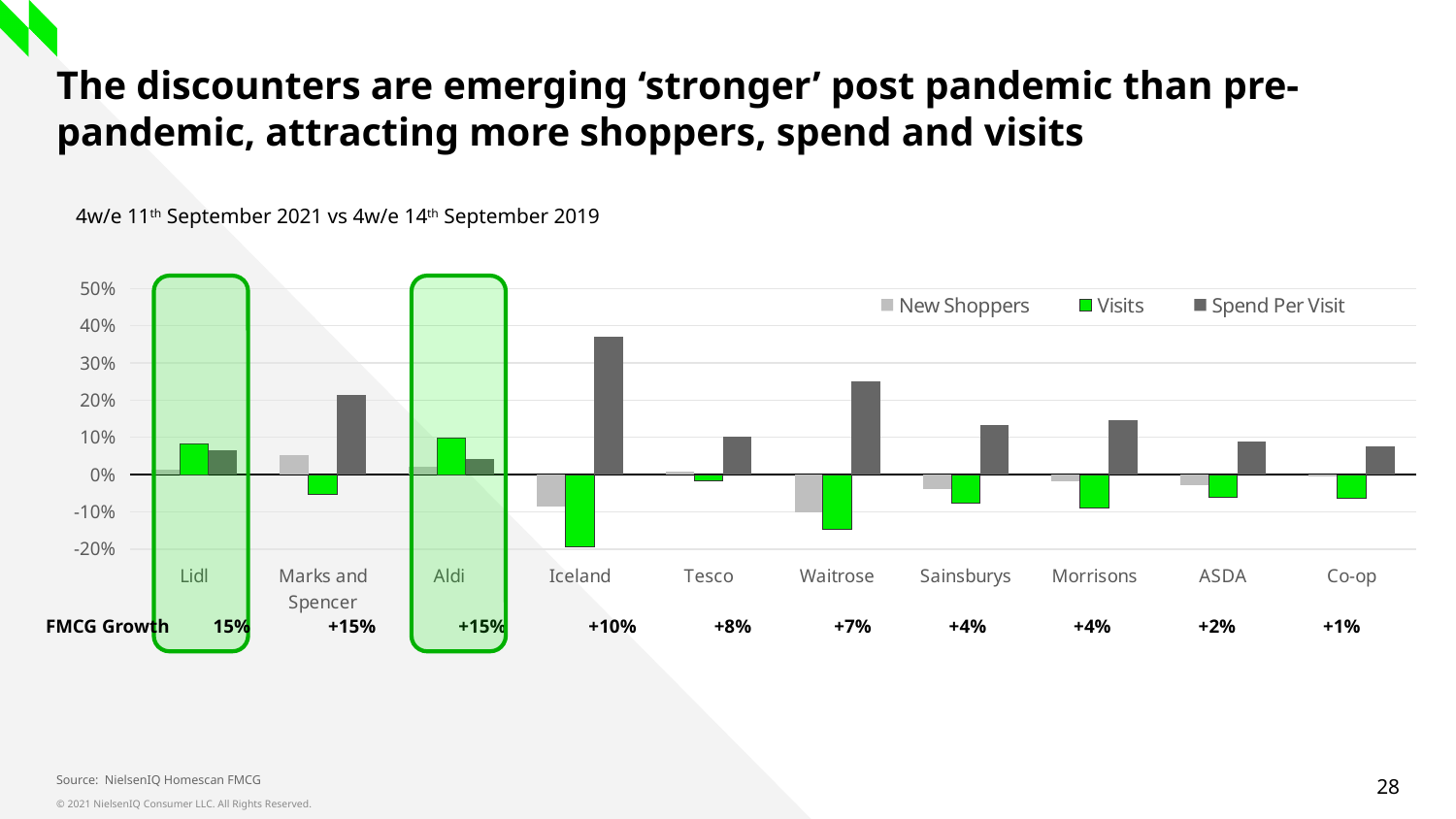
Which is larger, the Visits value for Lidl or for Marks and Spencer? Lidl Is the Spend Per Visit value for Marks and Spencer greater or less than 10%? greater Which retailer has the highest New Shoppers value? Marks and Spencer How many series does the chart's legend list? 3 Which is larger, the Spend Per Visit value for Iceland or for Waitrose? Iceland Which retailer has the lowest Visits value? Iceland Is the Visits value for Waitrose greater or less than -10%? less Which retailer has the highest Spend Per Visit value? Iceland What FMCG Growth figure is printed below the chart for Iceland? +10% What kind of chart is shown on the slide? bar chart How many retailers are shown on the x axis of the chart? 10 Is the Spend Per Visit value for Iceland greater or less than 30%? greater